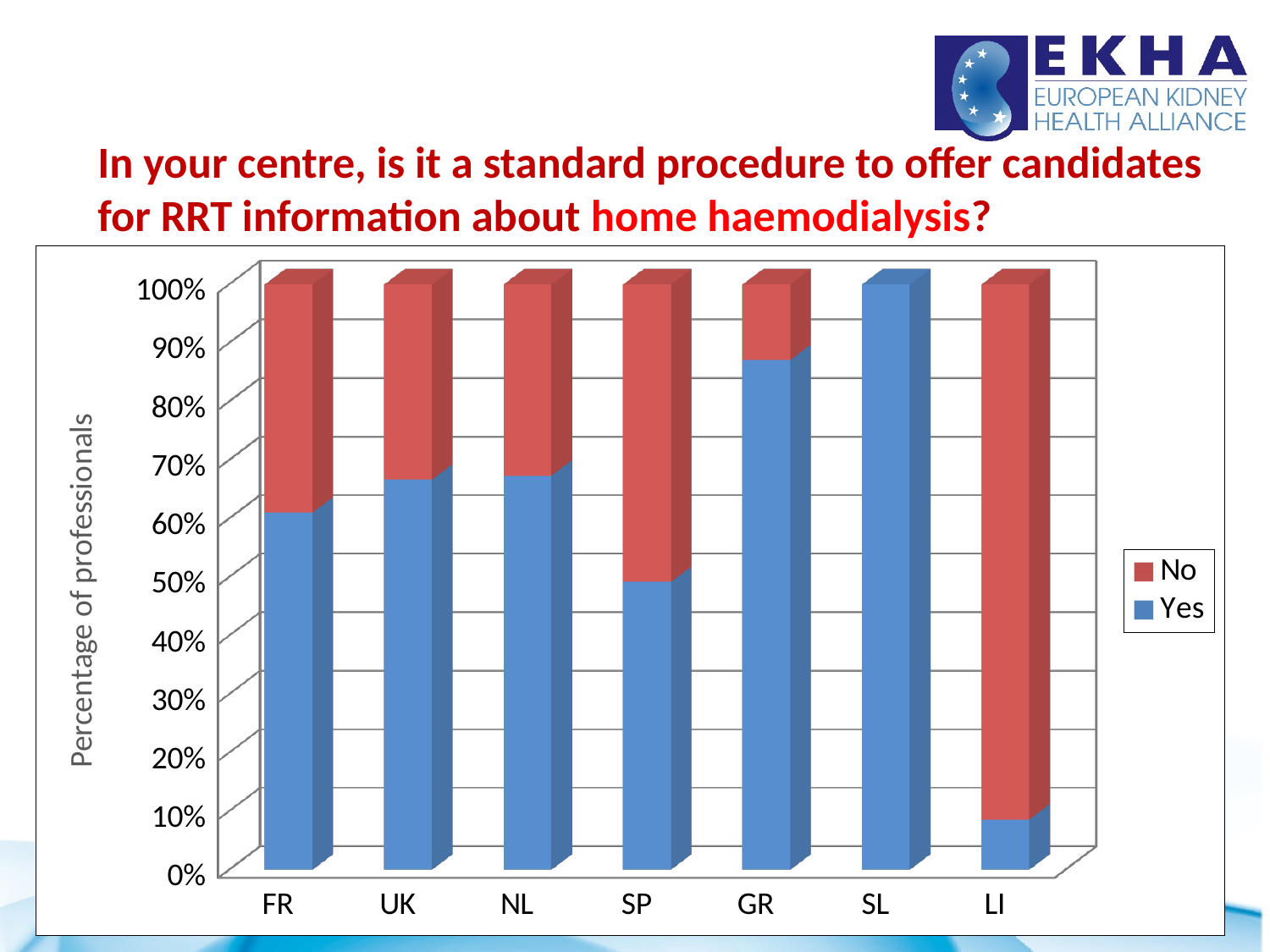
Is the 'Yes' value for LI greater or less than 20%? less Which country has the highest share of 'No' responses? LI What is the label on the vertical axis of the chart? Percentage of professionals Which has a larger 'Yes' share, GR or SP? GR Is the 'Yes' value for GR greater or less than 80%? greater What type of chart is shown on the slide? Bar chart How many countries are shown on the x axis of the chart? 7 What is the 'Yes' percentage for SL? 100% How many series does the chart legend list? 2 Which country has the highest share of 'Yes' responses? SL Is the 'Yes' value for FR greater or less than 50%? greater Which country has the lowest share of 'Yes' responses? LI